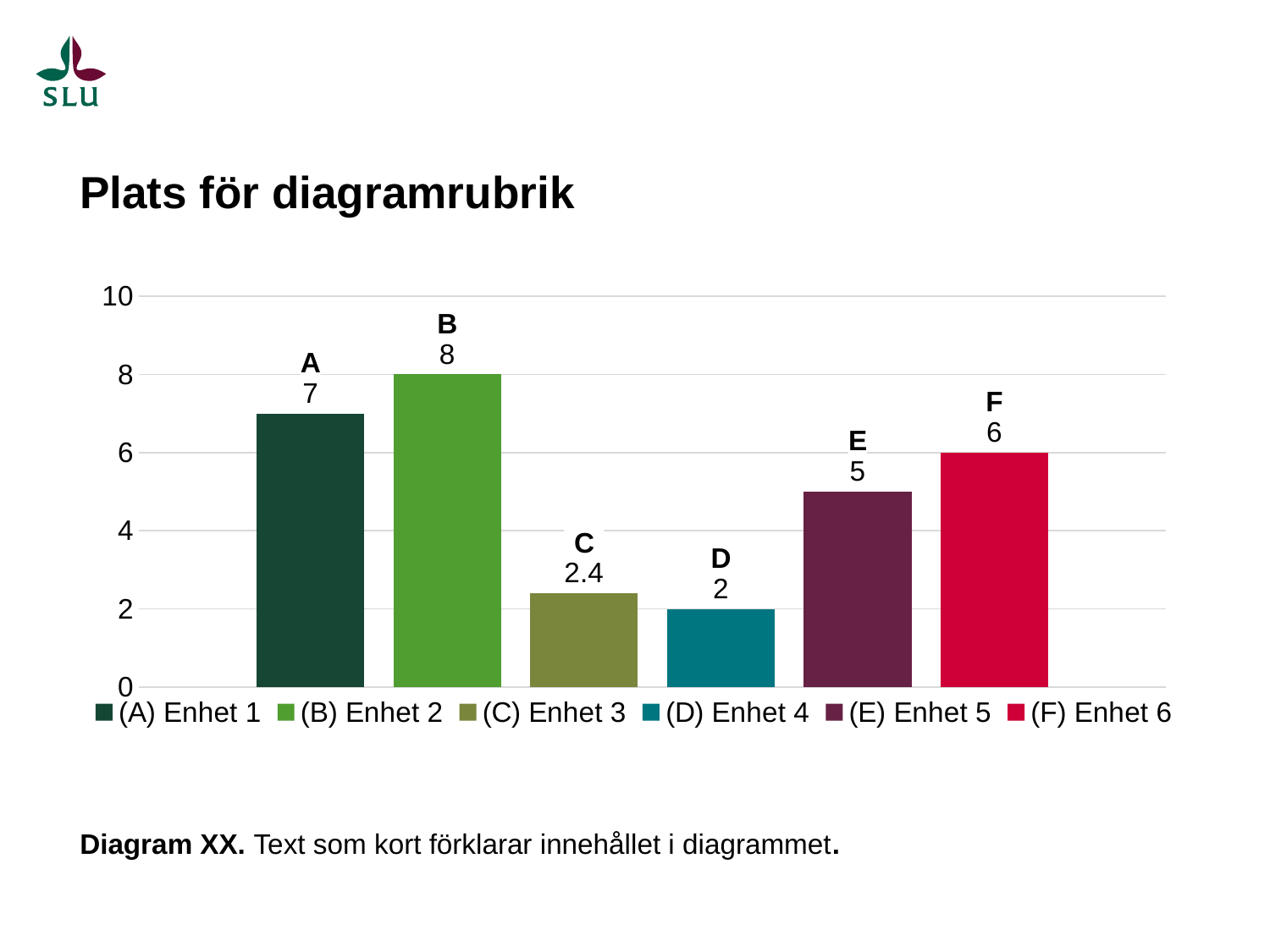
What kind of chart is shown on the slide? Bar chart Which is larger, the value for E or the value for F? F Which category has the lowest value? D What is the legend label for the bar labelled D? (D) Enhet 4 What is the value for E? 5 How many bars are shown in the chart? 6 What is the value for C? 2.4 Which category has the highest value? B What is the difference between the values for A and F? 1 How many entries does the legend list? 6 What is the value for B? 8 What is the difference between the values for C and D? 0.4